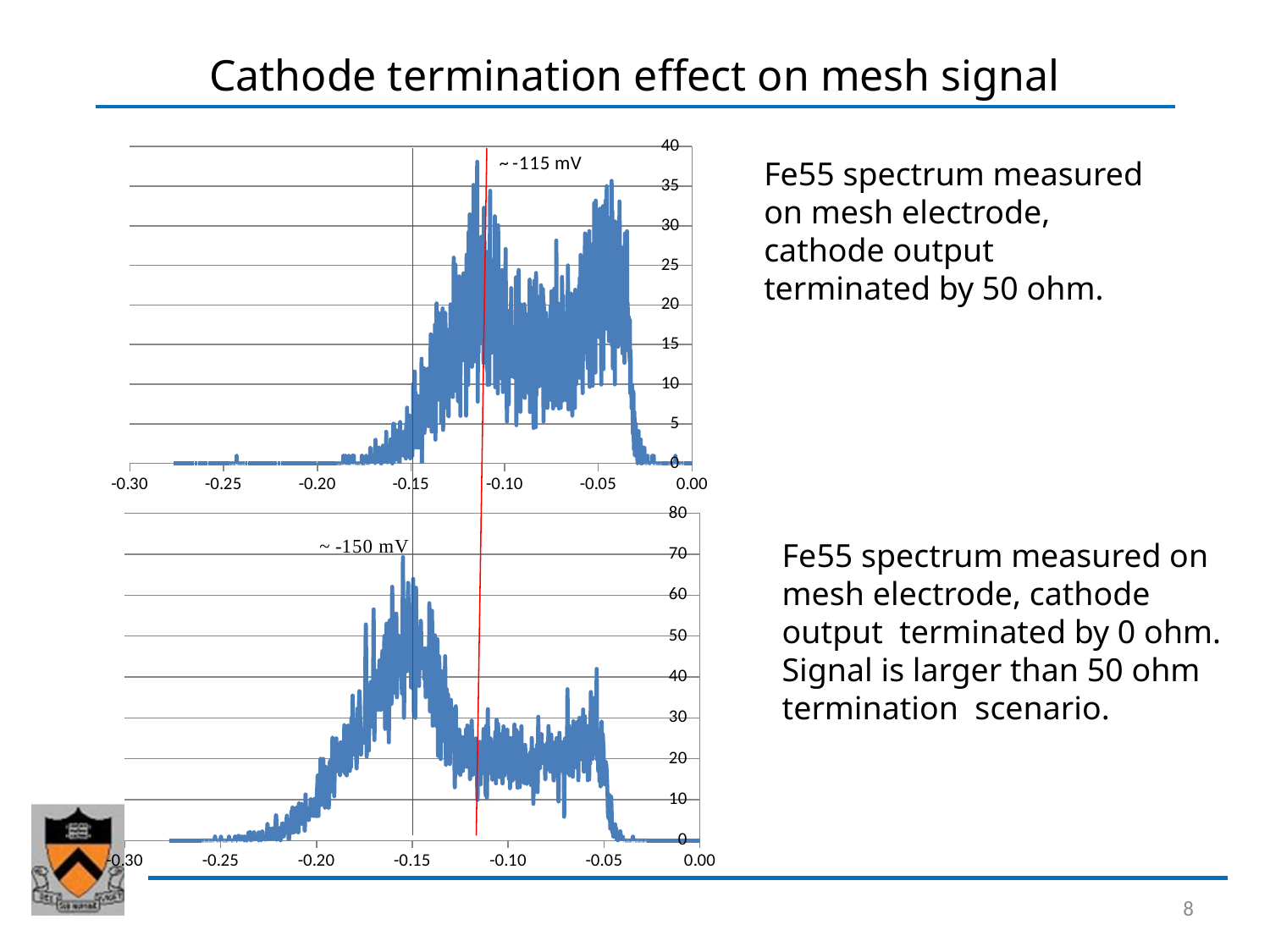
In the top chart (50 ohm termination), what is the maximum value shown on the vertical axis? 40 In the top chart, is the highest peak of the spectrum greater or less than 35? greater In the bottom chart, is the highest peak of the spectrum greater or less than 60? greater In the bottom chart (0 ohm termination), what is the maximum value shown on the vertical axis? 80 What is the leftmost value shown on the horizontal axis of the top chart? -0.30 How many charts are shown on the slide? 2 In the bottom chart, is the value at -0.10 on the horizontal axis greater or less than 40? less What kind of chart is the top chart on the slide? line chart What annotation value is written near the peak in the bottom chart? ~ -150 mV What annotation value is written near the peak in the top chart? ~ -115 mV Which chart reaches a higher peak count, the top chart (50 ohm) or the bottom chart (0 ohm)? the bottom chart (0 ohm)